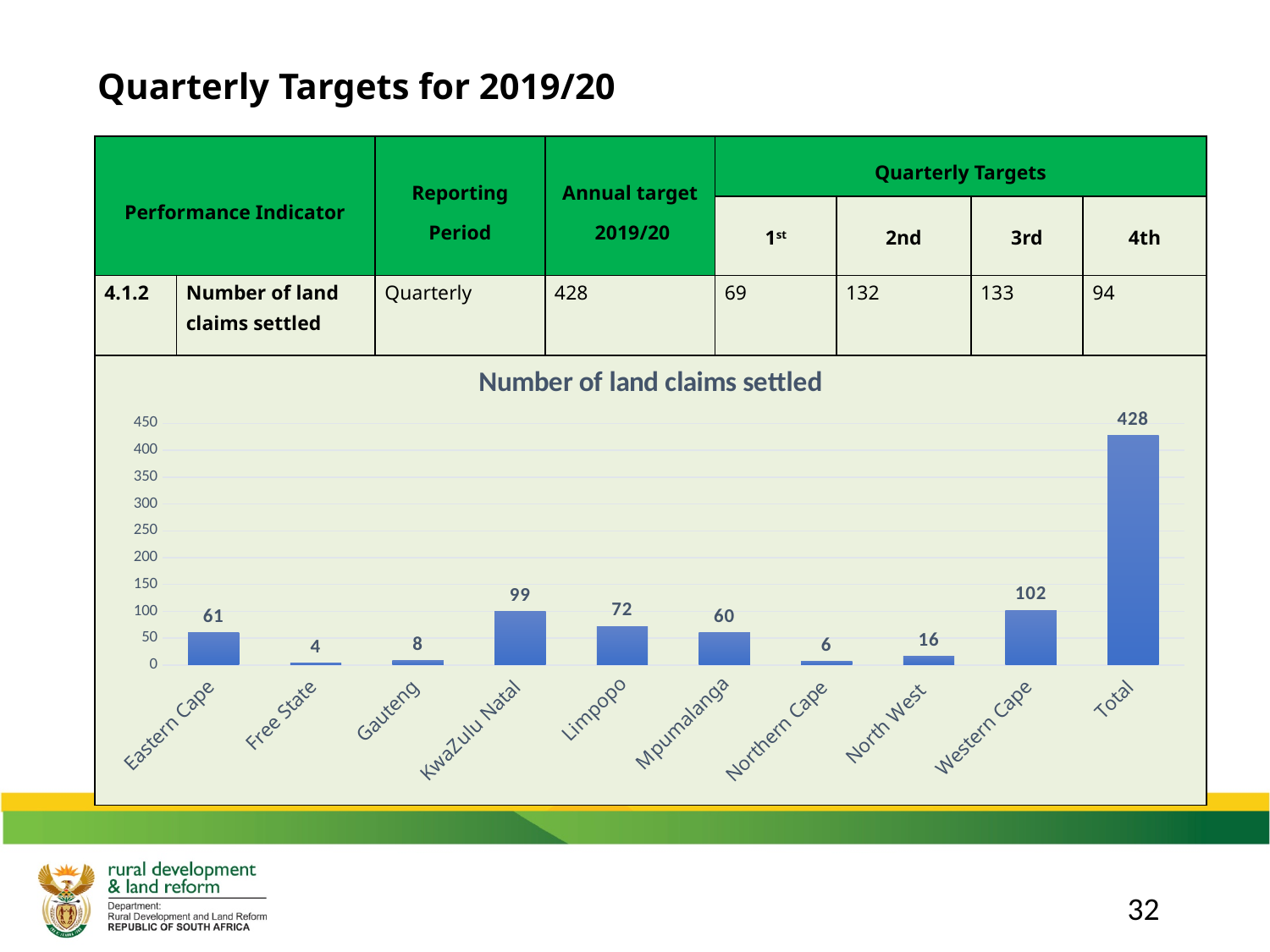
Is the value for Total greater or less than 400? greater Which is larger, the value for Eastern Cape or the value for North West? Eastern Cape Which province has the lowest number of land claims settled? Free State What is the title of the chart? Number of land claims settled What is the value for KwaZulu Natal in the chart? 99 What is the value for Free State in the chart? 4 What kind of chart is shown on the slide? Bar chart What is the value for Northern Cape in the chart? 6 What is the difference between the values for Limpopo and Mpumalanga? 12 Excluding the Total bar, which province has the highest number of land claims settled? Western Cape How many bars are shown in the chart, including the Total bar? 10 What is the value for Western Cape in the chart? 102